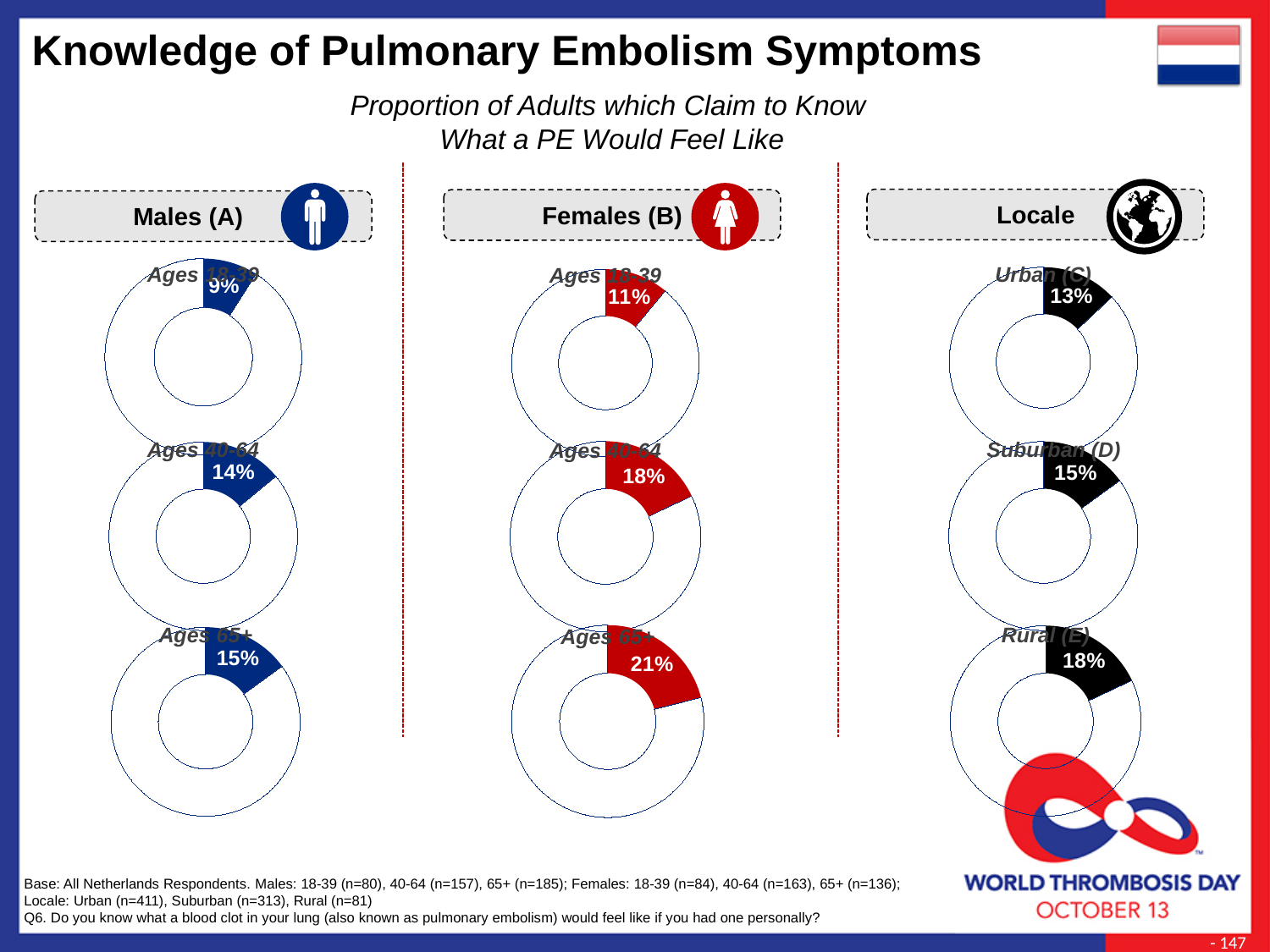
Among the three Locale donut charts, which locale has the highest value? Rural (E) What type of chart is used to show each value on this slide? Donut chart What is the difference between the Females (B) Ages 65+ value and the Males (A) Ages 65+ value? 6% In the Males (A) Ages 40-64 donut chart, what value is shown? 14% Among the three Females (B) donut charts, which age group has the highest value? Ages 65+ In the Locale Suburban (D) donut chart, what value is shown? 15% Which is larger: the Females (B) Ages 40-64 value or the Locale Urban (C) value? Females (B) Ages 40-64 Among the three Males (A) donut charts, which age group has the lowest value? Ages 18-39 In the Females (B) Ages 65+ donut chart, what value is shown? 21% How many donut charts are shown on the slide in total? 9 In the Males (A) Ages 18-39 donut chart, what proportion of adults claim to know what a PE would feel like? 9% What is the difference between the Locale Rural (E) value and the Locale Urban (C) value? 5%